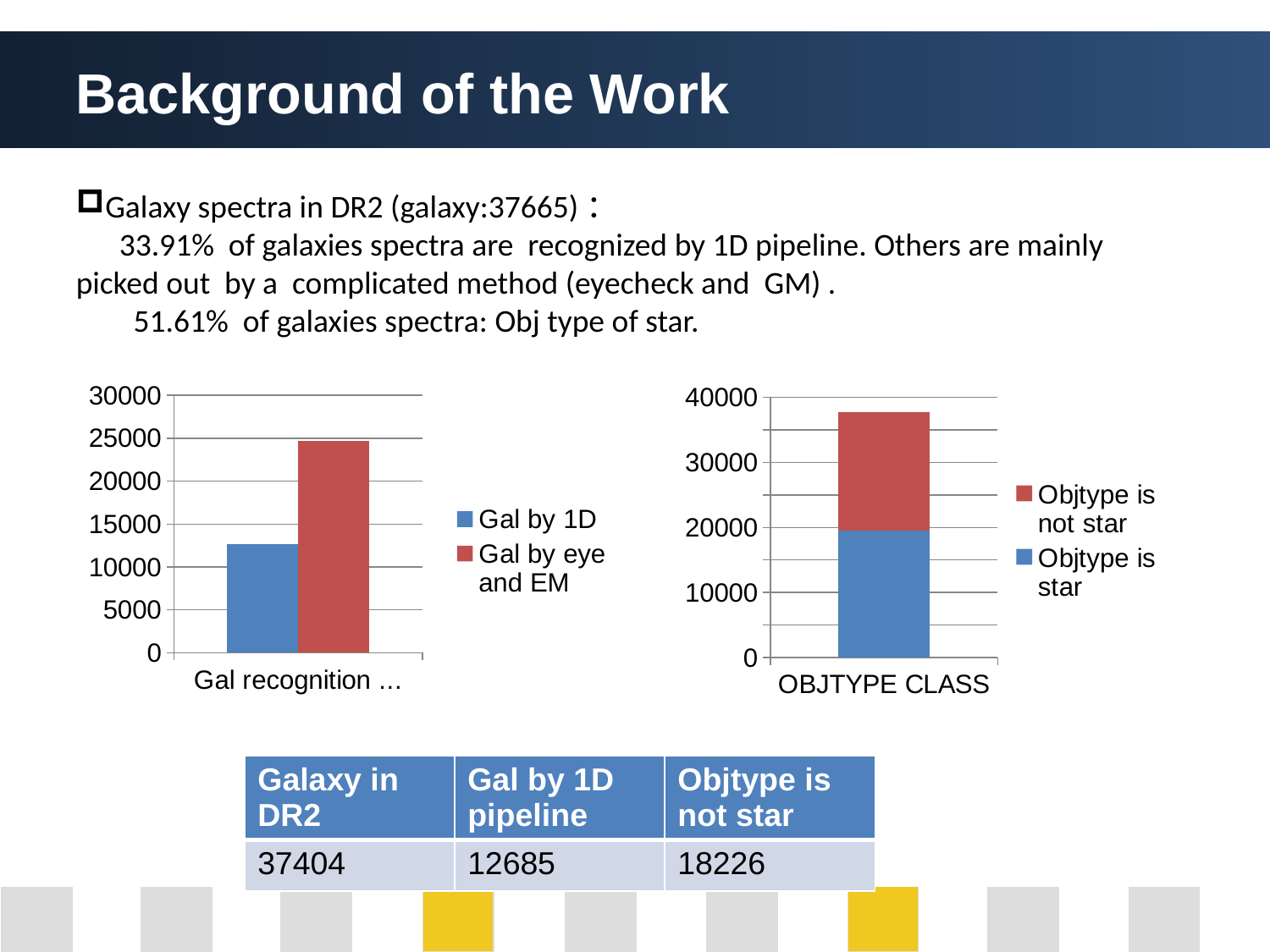
In the left chart, is the value for 'Gal by eye and EM' greater or less than 20000? greater In the left chart, is the value for 'Gal by 1D' greater or less than 15000? less In the right chart, which legend entry is shown in red? Objtype is not star In the left chart, which series has the taller bar, 'Gal by 1D' or 'Gal by eye and EM'? Gal by eye and EM In the right chart, is the total height of the stacked bar for 'OBJTYPE CLASS' greater or less than 40000? less What kind of chart is the right chart with the category 'OBJTYPE CLASS'? stacked bar chart In the right chart, how many series does the legend list? 2 What kind of chart is the left chart with the legend entries 'Gal by 1D' and 'Gal by eye and EM'? bar chart In the left chart, how many series does the legend list? 2 In the right chart, what is the category label on the x axis? OBJTYPE CLASS